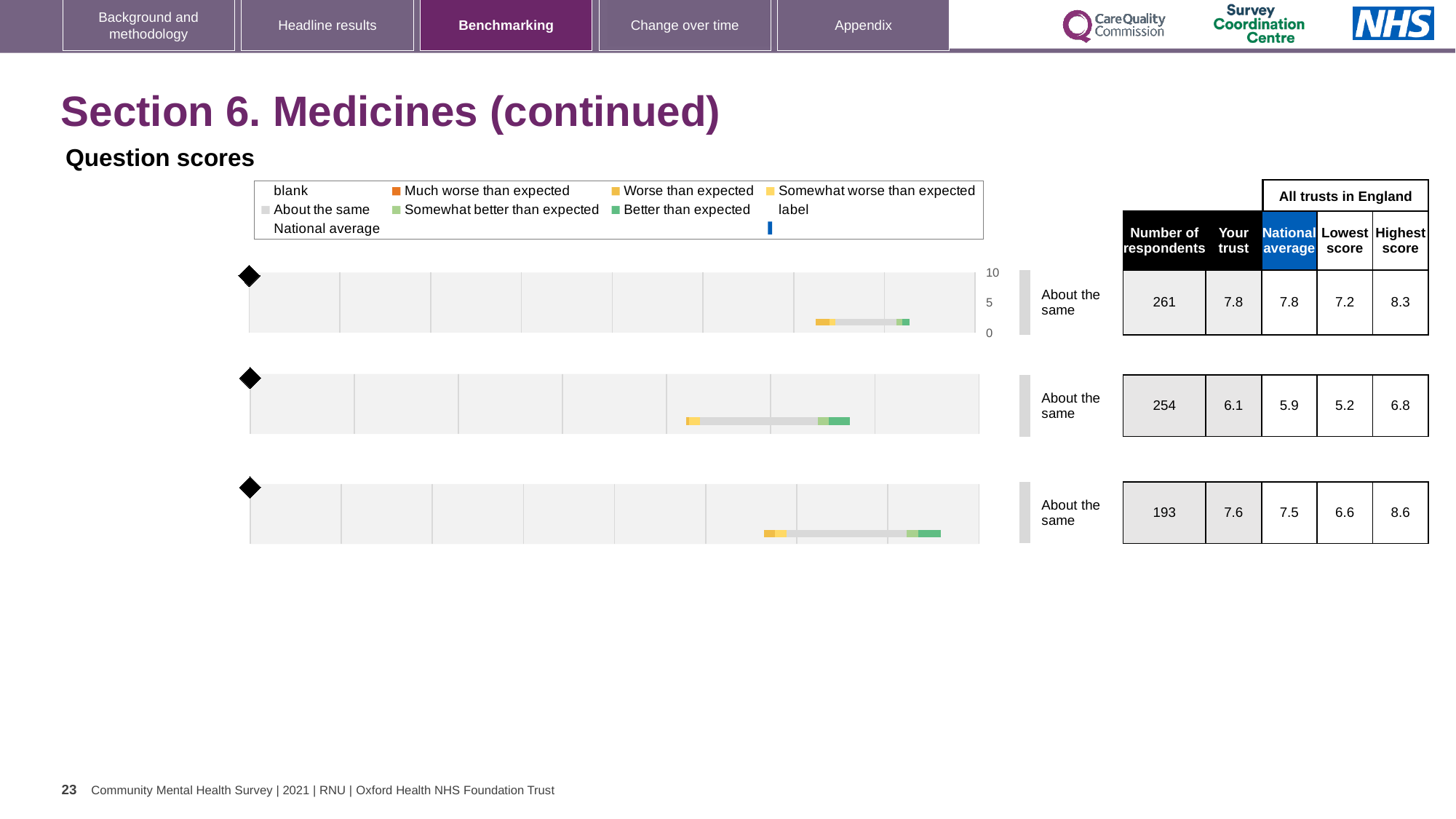
How many question score charts are shown on the slide? 3 In the table, what is the lowest score for the first (top) question? 7.2 Which of the three questions has the highest 'Highest score' value in the table? the third (bottom) question, 8.6 What benchmark category is shown next to each of the three charts? About the same For the second (middle) question, what is the difference between the 'Your trust' score and the national average? 0.2 In the table, how many respondents are listed for the third (bottom) question? 193 In the table, what is the national average for the second (middle) question? 5.9 In the table, what is the 'Your trust' score for the first (top) question? 7.8 Which of the three questions has the lowest 'Lowest score' value in the table? the second (middle) question, 5.2 What kind of chart is used to show the question scores on this slide? bar chart What is the highest tick value on the axis scale shown beside the first chart? 10 For the third (bottom) question, is the 'Your trust' score higher or lower than the national average? higher